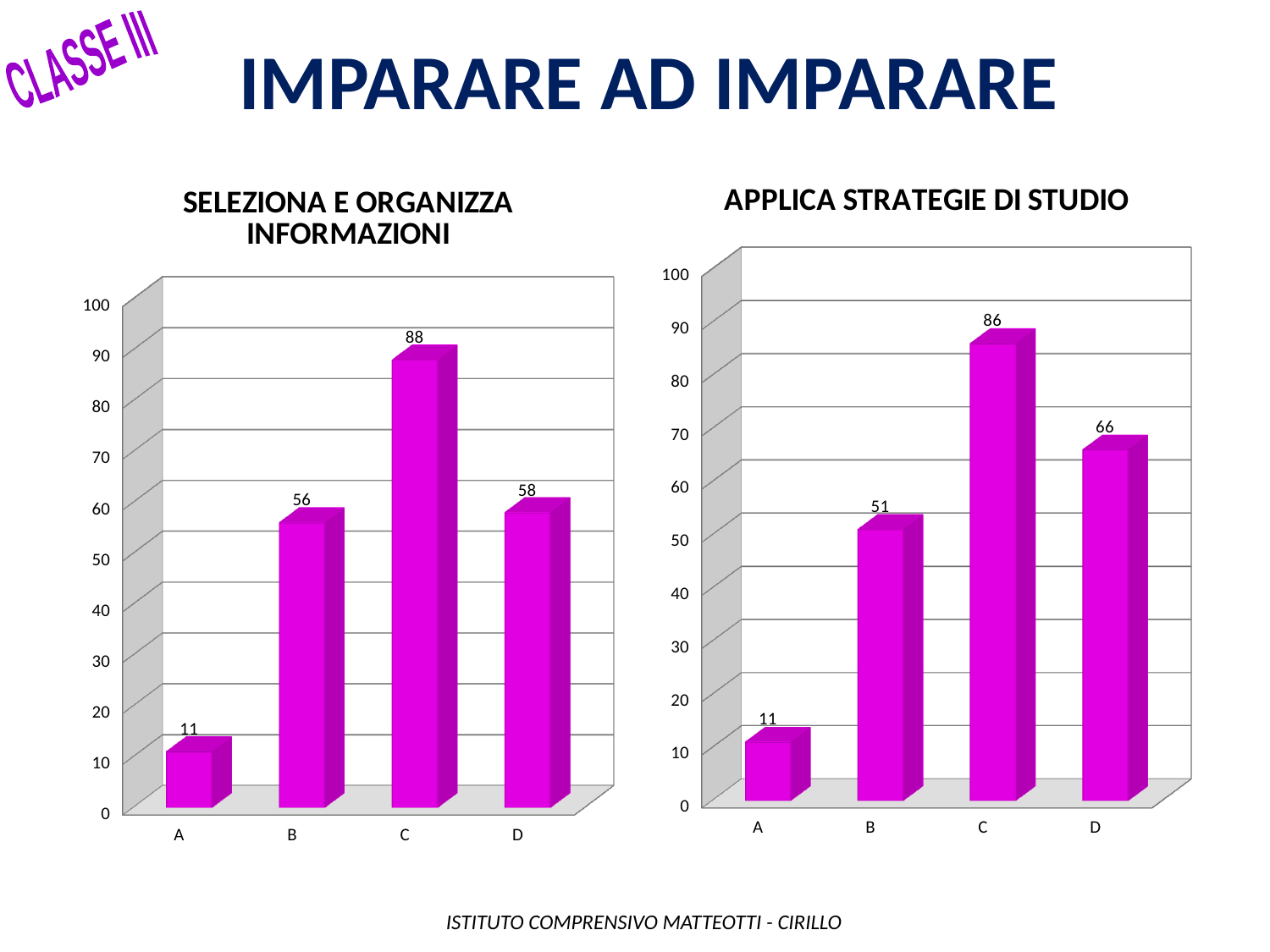
In the 'SELEZIONA E ORGANIZZA INFORMAZIONI' chart, what is the value for category A? 11 In the 'SELEZIONA E ORGANIZZA INFORMAZIONI' chart, which category has the lowest value? A In the 'APPLICA STRATEGIE DI STUDIO' chart, which category has the highest value? C In the 'SELEZIONA E ORGANIZZA INFORMAZIONI' chart, what is the value for category C? 88 In the 'SELEZIONA E ORGANIZZA INFORMAZIONI' chart, which is larger, the value for B or the value for D? D How many categories are shown in the 'APPLICA STRATEGIE DI STUDIO' chart? 4 In the 'SELEZIONA E ORGANIZZA INFORMAZIONI' chart, what is the difference between the values for C and B? 32 In the 'APPLICA STRATEGIE DI STUDIO' chart, what is the value for category D? 66 In the 'APPLICA STRATEGIE DI STUDIO' chart, what is the difference between the values for C and A? 75 What kind of chart is the 'SELEZIONA E ORGANIZZA INFORMAZIONI' chart? bar chart What is the title of the chart on the right side of the slide? APPLICA STRATEGIE DI STUDIO In the 'APPLICA STRATEGIE DI STUDIO' chart, is the value for B greater or less than 60? less